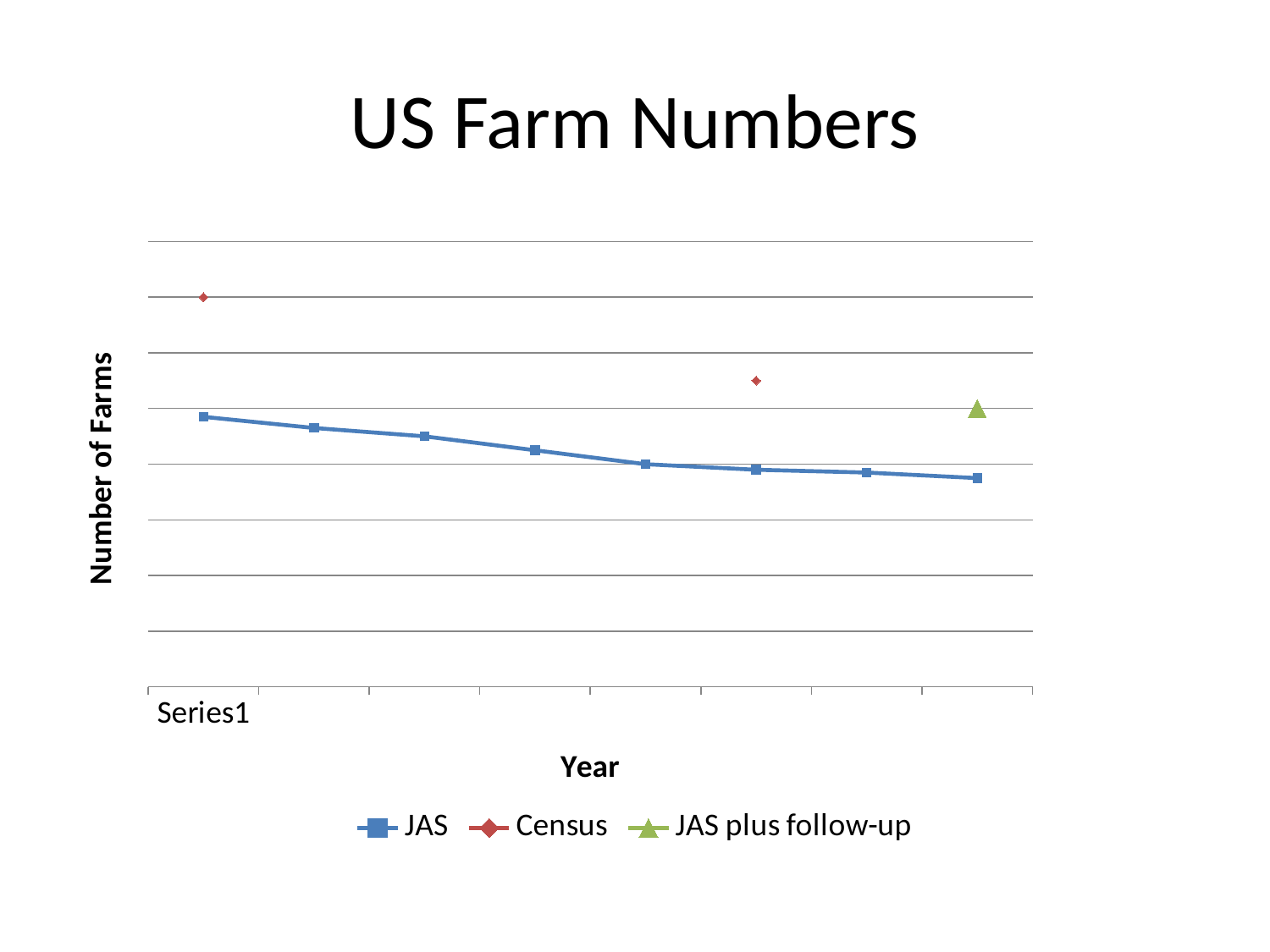
What kind of chart is shown on the slide? line chart How many data points are plotted for the JAS plus follow-up series? 1 How many series does the legend list? 3 Which of the two Census points is higher, the first or the second? the first Which series contains the highest plotted point on the chart? Census At the first x-axis position (Series1), which is larger, the Census value or the JAS value? Census How many data points are plotted for the Census series? 2 How many data points are plotted for the JAS series? 8 What is the title of the chart? US Farm Numbers At the last x-axis position, which is larger, the JAS plus follow-up value or the JAS value? JAS plus follow-up Which series are listed in the legend? JAS, Census, JAS plus follow-up Do the JAS values rise or fall along the x axis? fall